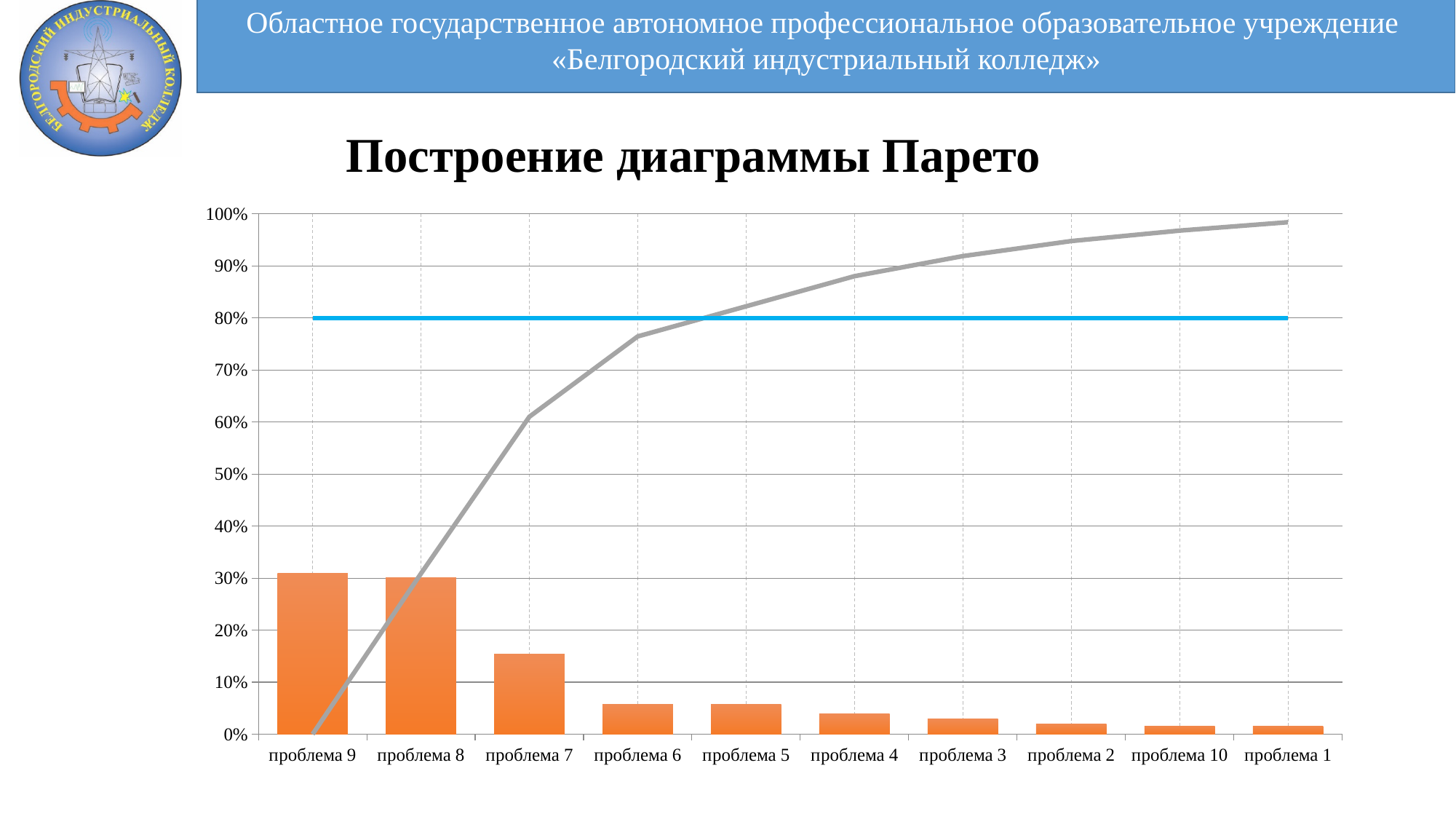
How many categories (problems) are shown on the x axis of the chart? 10 What is the title of the slide above the chart? Построение диаграммы Парето Is the bar value for проблема 7 greater or less than 20%? less Is the bar value for проблема 7 greater or less than 10%? greater Which bar is taller, проблема 8 or проблема 7? проблема 8 Which bar is taller, проблема 7 or проблема 6? проблема 7 Do the bar values rise or fall from left to right along the x axis? fall Is the bar value for проблема 9 greater or less than 20%? greater What kind of chart is shown on the slide? bar chart with a line At what level on the y axis is the horizontal blue line drawn? 80%